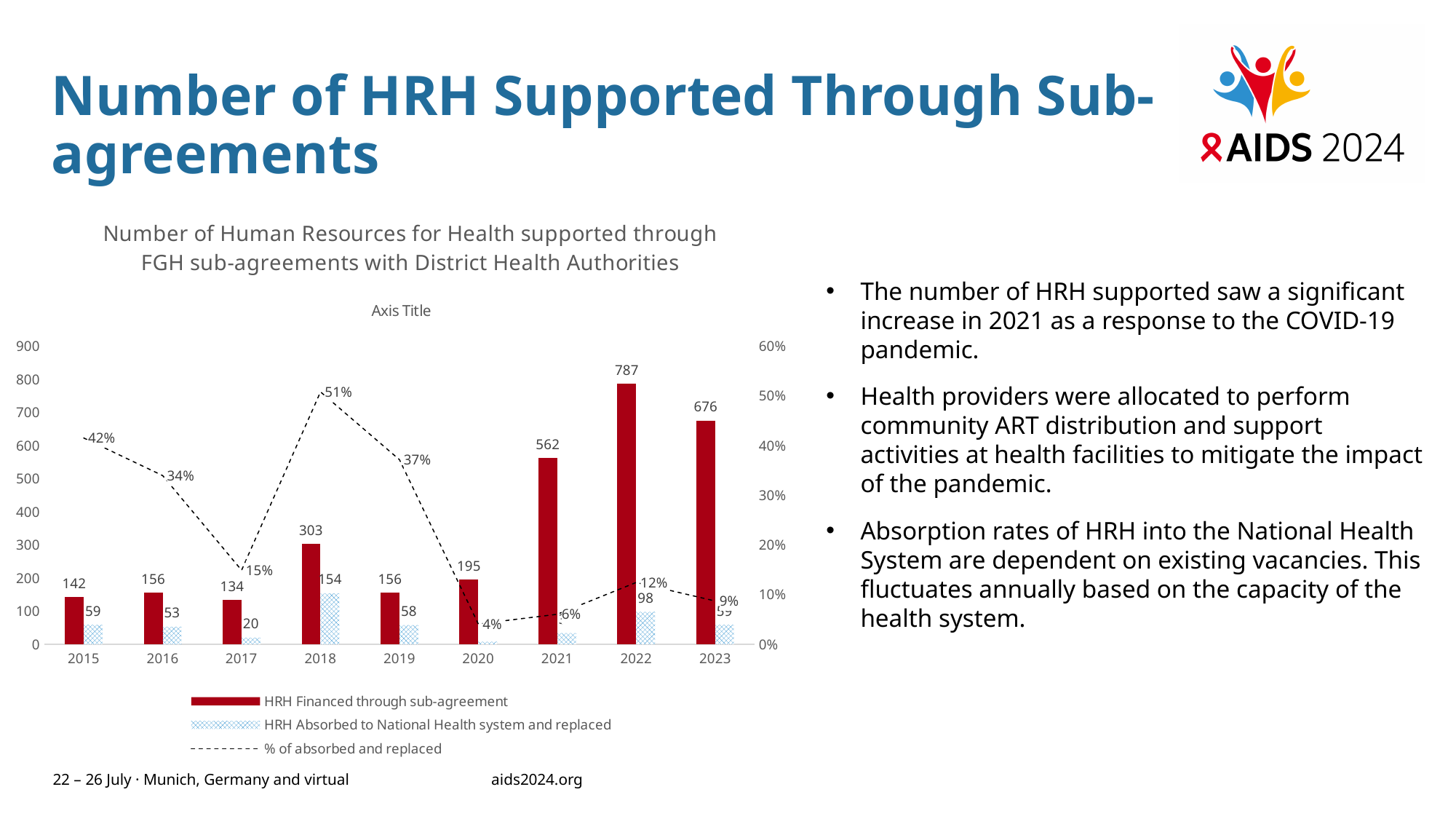
Which year had more HRH Financed through sub-agreement, 2018 or 2019? 2018 In which year was the number of HRH Financed through sub-agreement highest? 2022 What is the value of HRH Absorbed to National Health system and replaced in 2018? 154 In which year was the number of HRH Financed through sub-agreement lowest? 2017 What kind of chart is shown on the slide? Bar chart with a line How many years are shown on the x axis of the chart? 9 What is the value of HRH Financed through sub-agreement in 2022? 787 Is the value of HRH Financed through sub-agreement in 2021 greater or less than 500? greater How many series does the chart legend list? 3 Does the % of absorbed and replaced rise or fall from 2018 to 2020? Fall What is the difference between HRH Financed through sub-agreement in 2022 and in 2021? 225 What is the % of absorbed and replaced in 2018? 51%